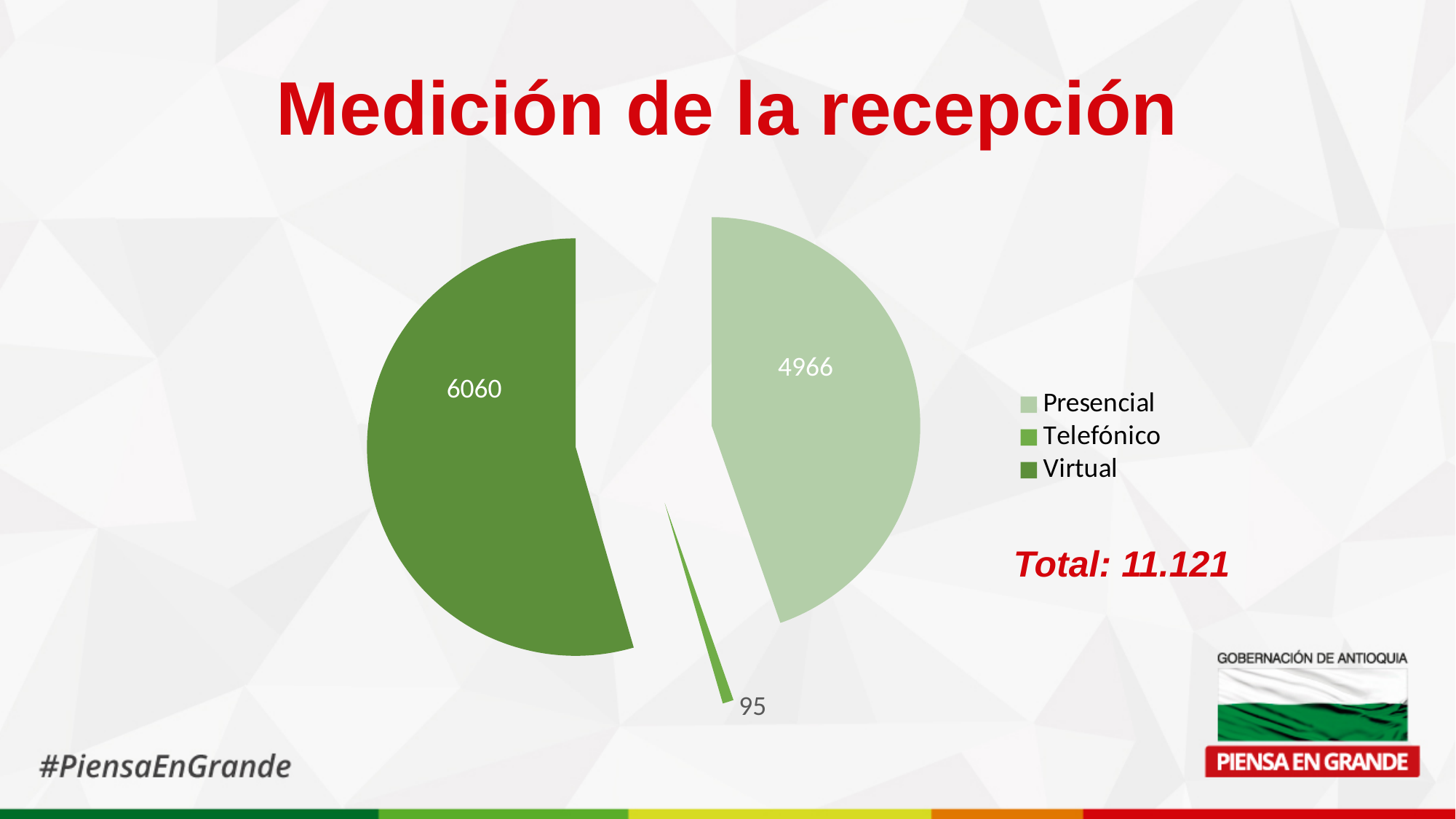
Which is larger, Presencial or Virtual? Virtual What is the value for Presencial? 4966 What is the difference between the Presencial and Telefónico values? 4871 Which category has the largest slice of the pie? Virtual What is the value for Virtual? 6060 What is the value for Telefónico? 95 What is the difference between the Virtual and Presencial values? 1094 What total is printed on the slide for the chart? 11.121 How many categories does the pie chart have? 3 Which category has the smallest slice of the pie? Telefónico What type of chart is shown on the slide? pie chart What is the title of the slide containing the chart? Medición de la recepción